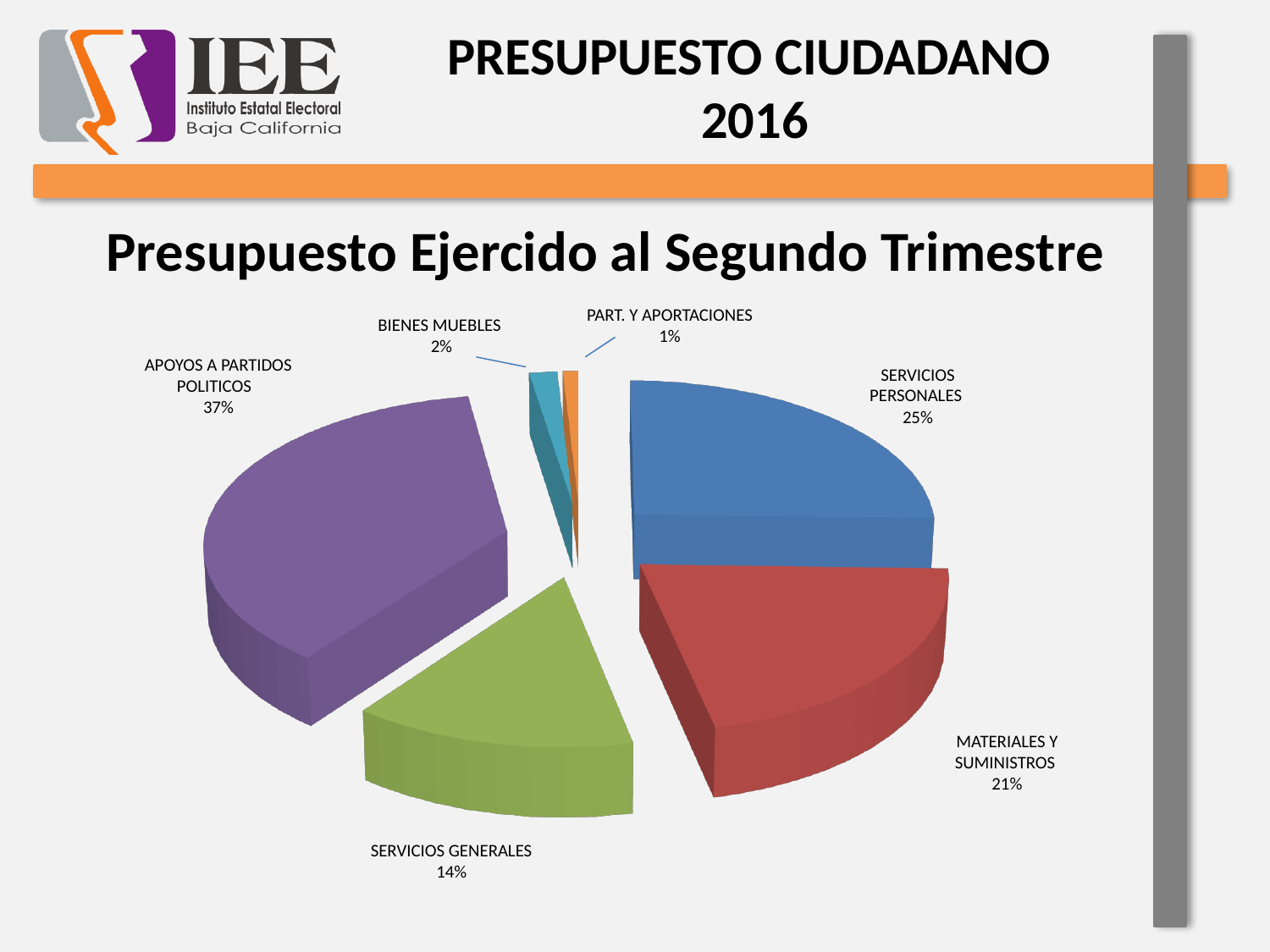
Which is larger, SERVICIOS PERSONALES or MATERIALES Y SUMINISTROS? SERVICIOS PERSONALES What type of chart is shown on the slide? Pie chart What share of the pie does APOYOS A PARTIDOS POLITICOS represent? 37% Which category has the smallest share of the pie? PART. Y APORTACIONES What percentage is shown for BIENES MUEBLES? 2% Which category has the largest share of the pie? APOYOS A PARTIDOS POLITICOS What percentage is shown for SERVICIOS PERSONALES? 25% What percentage is shown for MATERIALES Y SUMINISTROS? 21% What percentage is shown for PART. Y APORTACIONES? 1% How many categories are shown in the pie chart? 6 What percentage is shown for SERVICIOS GENERALES? 14% What is the difference in percentage points between APOYOS A PARTIDOS POLITICOS and SERVICIOS GENERALES? 23